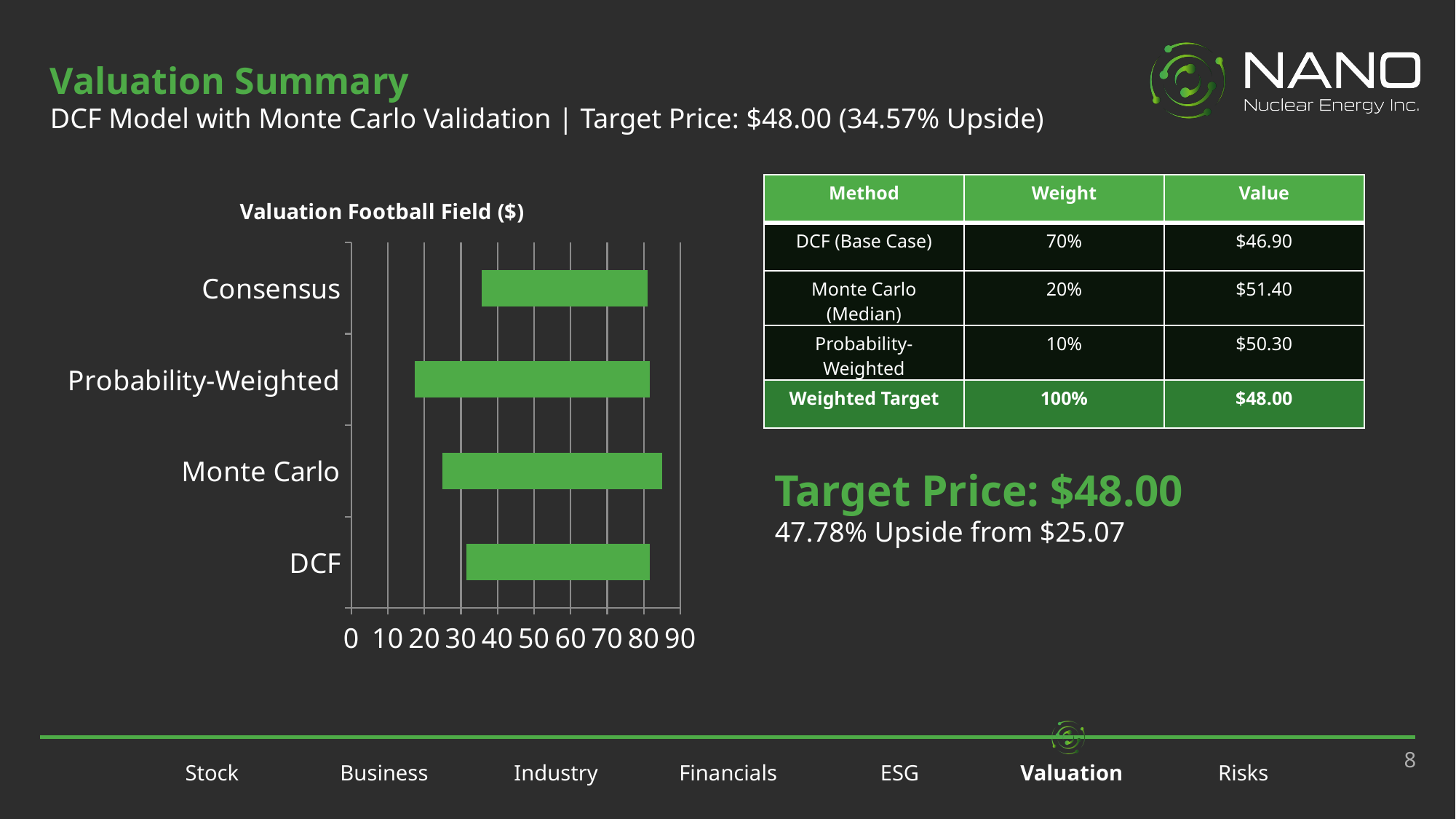
How many categories are shown on the Valuation Football Field ($) chart? 4 What is the highest value shown on the x axis of the Valuation Football Field chart? 90 Which category's bar extends furthest to the left (lowest low end) on the Valuation Football Field chart? Probability-Weighted Is the lower end of the Consensus bar greater or less than 30? greater Is the lower end of the Monte Carlo bar greater or less than 30? less Is the upper end of the Consensus bar greater or less than 70? greater What is the title of the chart on the slide? Valuation Football Field ($) Which category's bar extends furthest to the right (highest high end) on the Valuation Football Field chart? Monte Carlo Which category is listed at the bottom of the Valuation Football Field chart? DCF Which bar is wider on the Valuation Football Field chart, Probability-Weighted or Consensus? Probability-Weighted What kind of chart is the Valuation Football Field ($) chart? bar chart